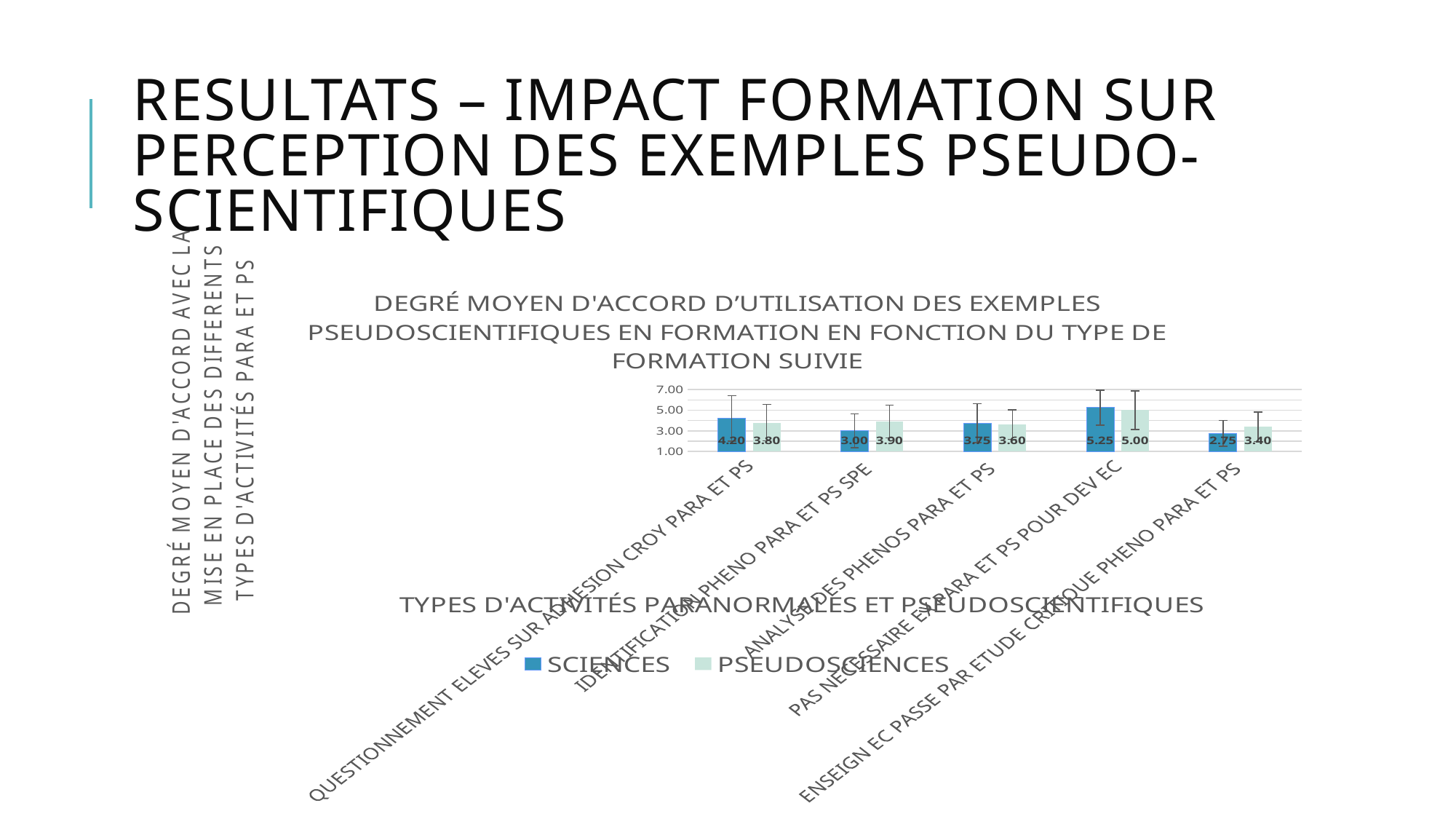
What is the PSEUDOSCIENCES value for the second category (IDENTIFICATION PHENO PARA ET PS SPE)? 3.90 Which category has the highest SCIENCES value? PAS NECESSAIRE EX PARA ET PS POUR DEV EC (fourth category) How many categories are plotted along the x axis? 5 What is the difference between the SCIENCES value of the first category and the SCIENCES value of the last category? 1.45 Which series is shown in the darker blue colour in the legend? SCIENCES What is the SCIENCES value for the last category (ENSEIGN EC PASSE PAR ETUDE CRITIQUE PHENO PARA ET PS)? 2.75 For the second category (IDENTIFICATION PHENO PARA ET PS SPE), which series has the larger value, SCIENCES or PSEUDOSCIENCES? PSEUDOSCIENCES What is the difference between the SCIENCES and PSEUDOSCIENCES values for the fourth category? 0.25 Which category has the lowest SCIENCES value? ENSEIGN EC PASSE PAR ETUDE CRITIQUE PHENO PARA ET PS (last category) What type of chart is shown on the slide? bar chart How many series does the legend list? 2 What is the SCIENCES value for the first category (QUESTIONNEMENT ELEVES SUR ADHESION CROY PARA ET PS)? 4.20